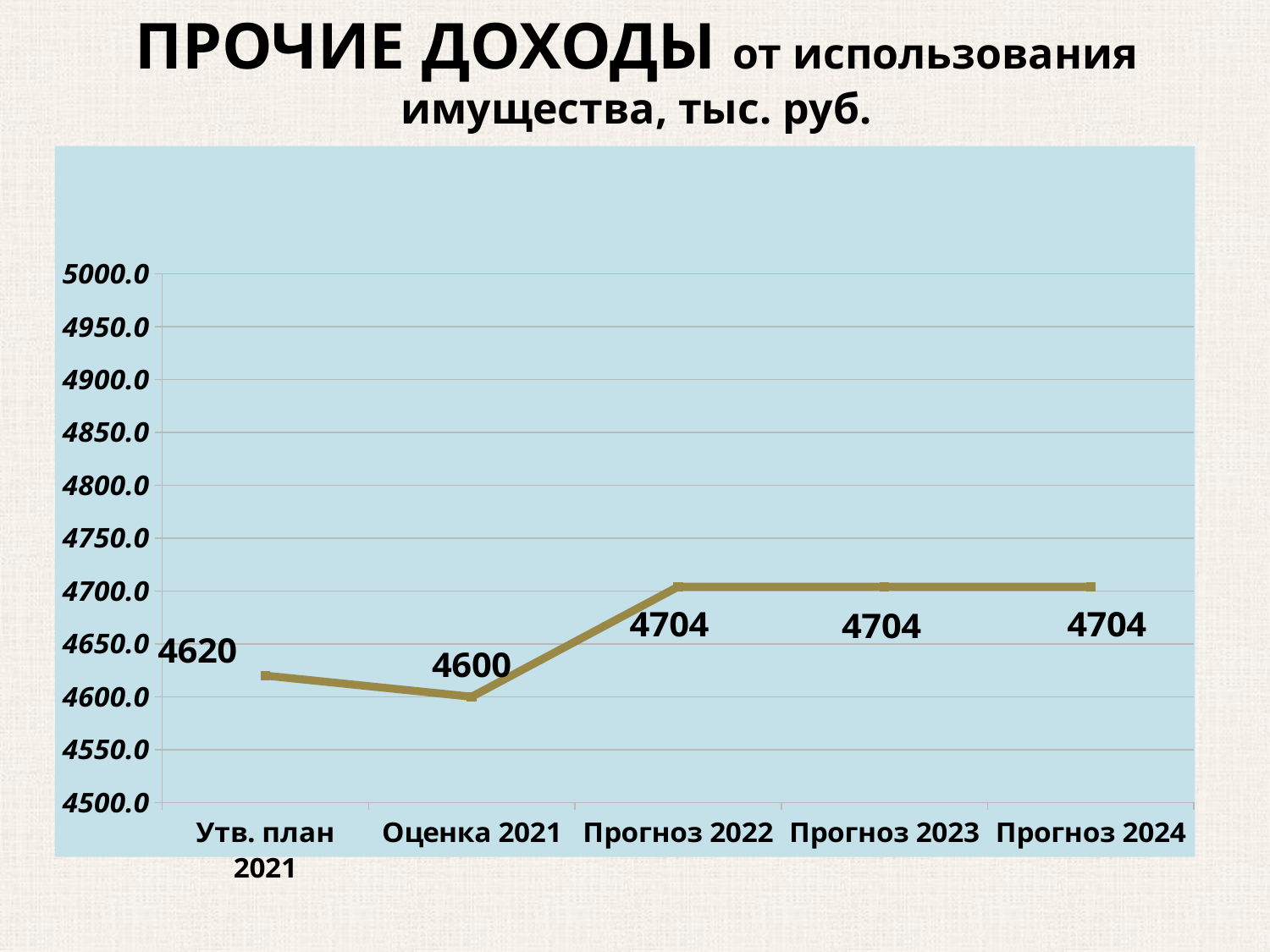
What is the difference between the values for Прогноз 2022 and Оценка 2021? 104 Is the value for Прогноз 2024 greater or less than 4650.0? greater What is the value for Оценка 2021? 4600 How many categories are shown on the x axis? 5 What kind of chart is shown on the slide? line chart What is the difference between the values for Утв. план 2021 and Оценка 2021? 20 Does the line rise or fall from Оценка 2021 to Прогноз 2022? rise What unit is stated in the chart title? тыс. руб. What is the value for Прогноз 2023? 4704 What is the value for Утв. план 2021? 4620 Which category has the lowest value? Оценка 2021 Which is larger, the value for Утв. план 2021 or the value for Оценка 2021? Утв. план 2021